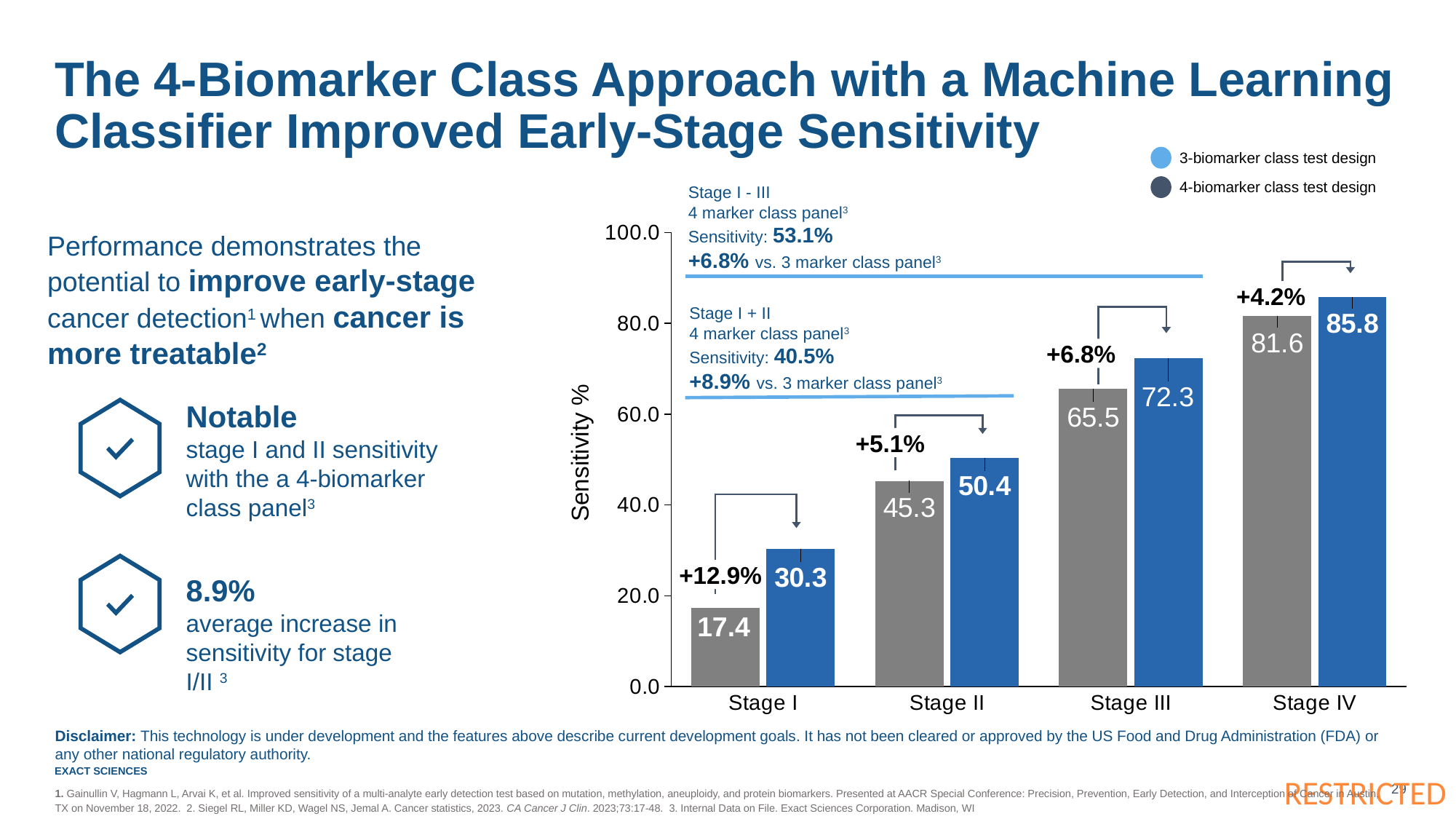
Which is larger at Stage III: the 3-biomarker class test design or the 4-biomarker class test design? 4-biomarker class test design Which stage has the highest sensitivity for the 4-biomarker class test design? Stage IV What is the sensitivity for the 3-biomarker class test design at Stage III? 65.5 Which stage has the lowest sensitivity for the 3-biomarker class test design? Stage I Do the sensitivity values rise or fall from Stage I to Stage IV? Rise How many stages are shown on the x axis? 4 What is the difference between the 4-biomarker and 3-biomarker sensitivity at Stage I? 12.9 What is the sensitivity for the 4-biomarker class test design at Stage I? 30.3 What is the sensitivity for the 4-biomarker class test design at Stage IV? 85.8 What is the sensitivity for the 3-biomarker class test design at Stage II? 45.3 How many series does the legend list? 2 What kind of chart is shown on the slide? Bar chart